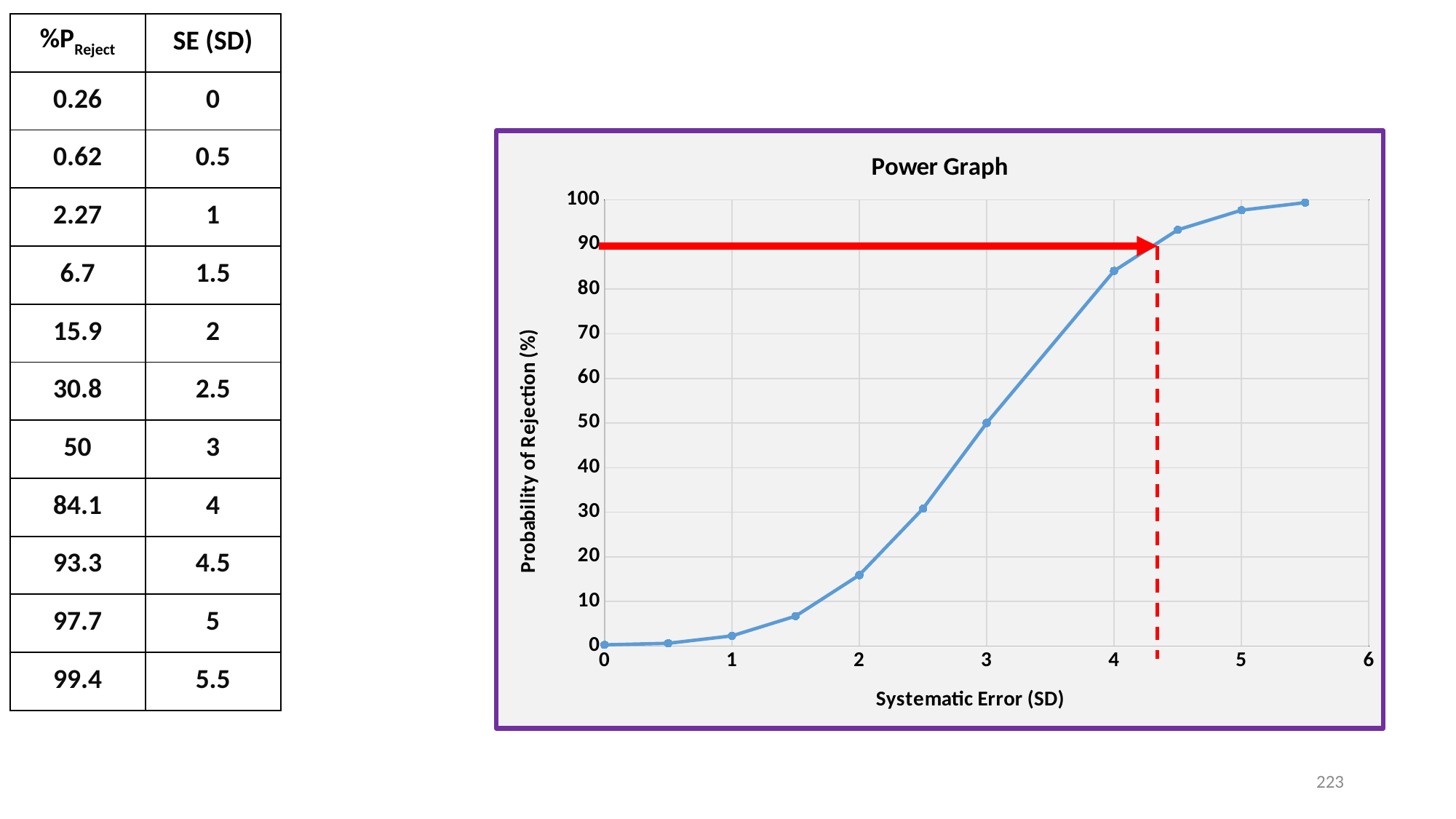
What is the title of the chart? Power Graph Which is larger: the probability of rejection at 2.5 SD or at 4 SD? 4 SD Is the probability of rejection at a systematic error of 2 SD greater or less than 20? less How many data points are plotted on the Power Graph line? 11 Using the table values, what is the difference in probability of rejection (%) between a systematic error of 4 SD and 3 SD? 34.1 According to the table on the slide, what is the probability of rejection (%) at a systematic error of 3 SD? 50 According to the table on the slide, what is the probability of rejection (%) at a systematic error of 5.5 SD? 99.4 Does the probability of rejection rise or fall as systematic error increases along the x axis? rise Is the probability of rejection at a systematic error of 4.5 SD greater or less than 90? greater According to the table on the slide, what is the probability of rejection (%) at a systematic error of 4 SD? 84.1 What is the label of the x axis of the Power Graph? Systematic Error (SD) What kind of chart is the Power Graph? line chart